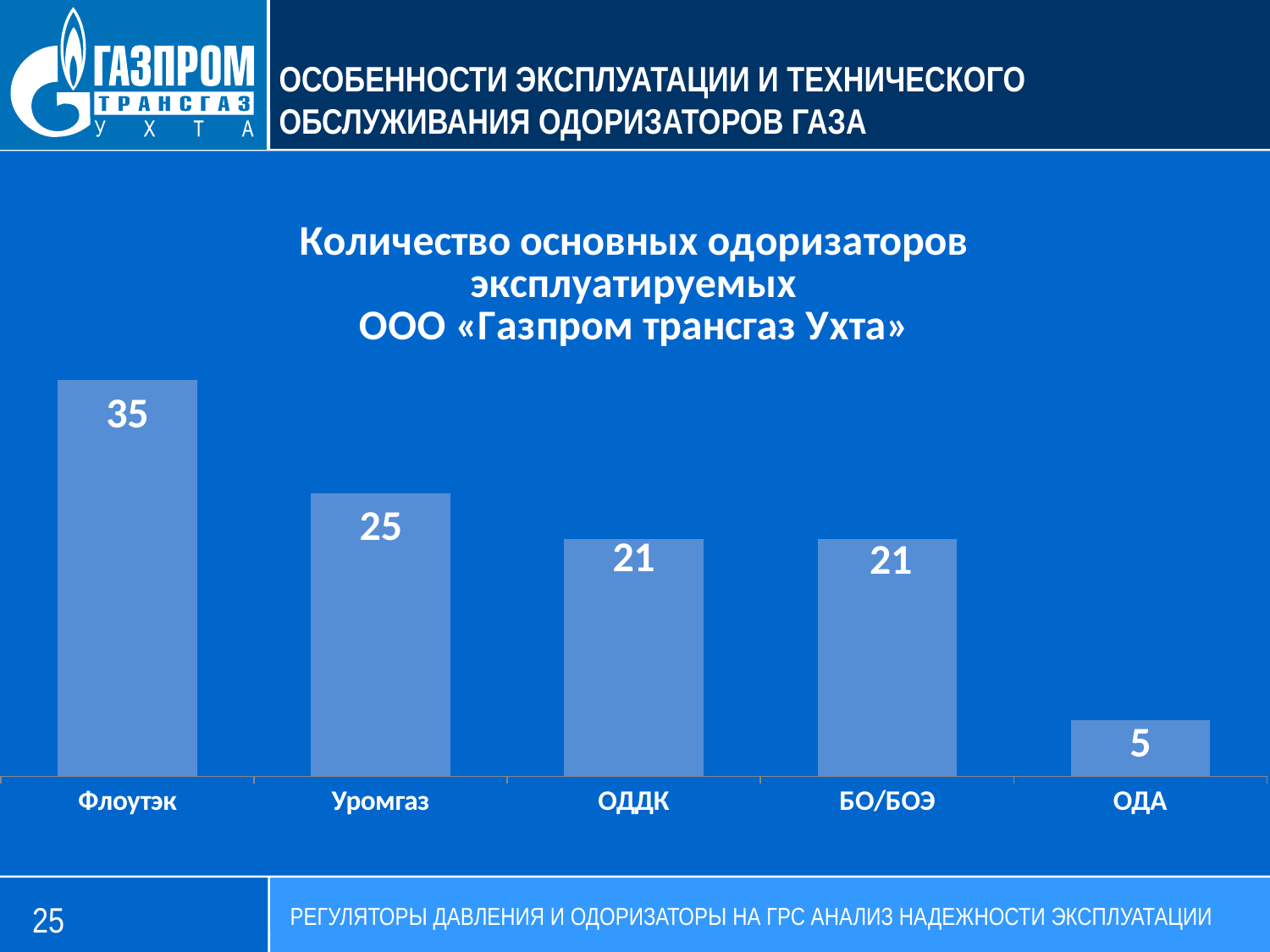
What is the difference between the values for БО/БОЭ and ОДА? 16 What is the value for Флоутэк? 35 What is the value for ОДДК? 21 Which category has the highest value? Флоутэк Which is larger, the value for Уромгаз or the value for ОДДК? Уромгаз What is the difference between the values for Флоутэк and Уромгаз? 10 What is the value for Уромгаз? 25 What kind of chart is shown on the slide? Bar chart How many categories are shown in the chart? 5 What is the value for ОДА? 5 What is the title of the chart? Количество основных одоризаторов эксплуатируемых ООО «Газпром трансгаз Ухта» Which category has the lowest value? ОДА